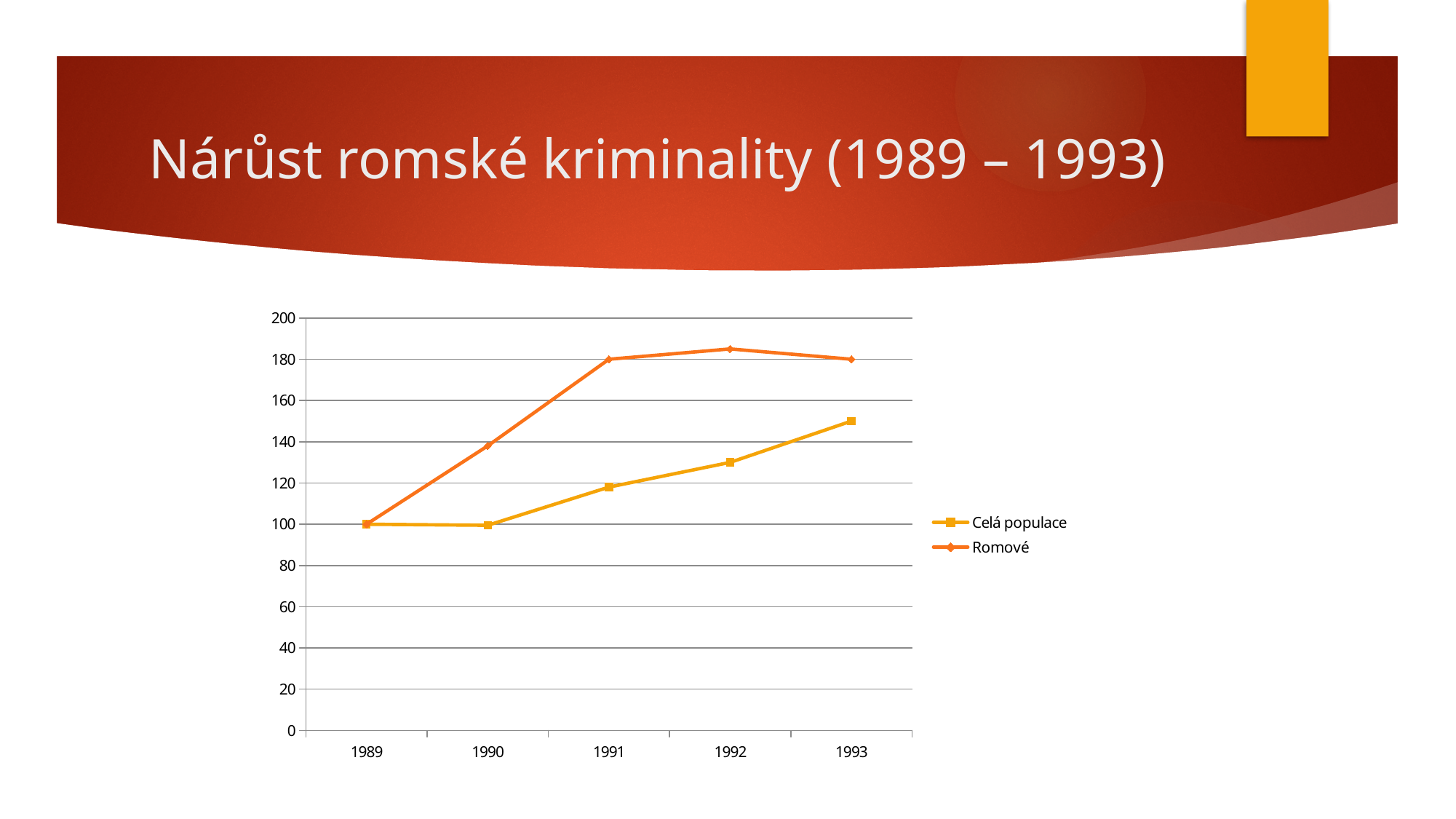
By how much did the Romové value increase from 1989 to 1991? 80 Is the value for Romové in 1990 greater or less than 120? greater What kind of chart is shown on the slide? line chart What is the value for Romové in 1991? 180 In 1992, which series has the higher value, Celá populace or Romové? Romové In which year does Celá populace reach its highest value? 1993 What are the two series named in the legend? Celá populace and Romové How many years are plotted on the x axis? 5 Is the value for Celá populace in 1993 greater or less than 140? greater Does the Celá populace series rise or fall from 1990 to 1993? rise How many series does the legend list? 2 What is the value for Celá populace in 1989? 100